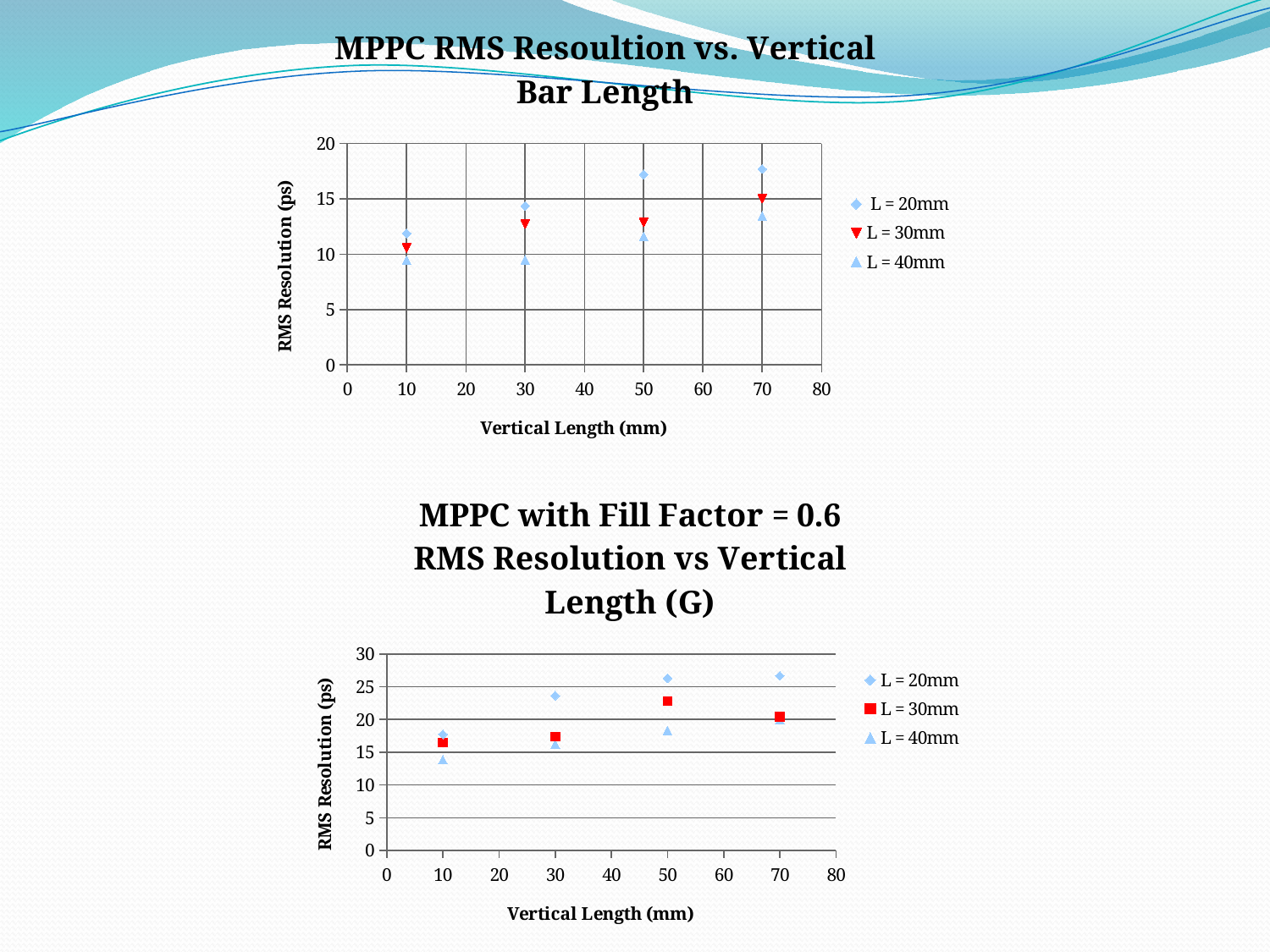
In the top chart, does the RMS resolution for L = 20mm rise or fall as vertical length increases? rise In the top chart, how many series does the legend list? 3 In the bottom chart, 'MPPC with Fill Factor = 0.6', how many series does the legend list? 3 In the bottom chart, is the RMS resolution for L = 20mm at a vertical length of 50 mm greater or less than 25? greater In the top chart, which series has the highest RMS resolution at a vertical length of 70 mm? L = 20mm In the top chart, how many vertical length points are plotted for the L = 20mm series? 4 In the top chart, is the RMS resolution for L = 40mm at a vertical length of 70 mm greater or less than 15? less In the bottom chart, at a vertical length of 50 mm, which series has the larger RMS resolution, L = 30mm or L = 40mm? L = 30mm In the top chart, at a vertical length of 50 mm, which series has the larger RMS resolution, L = 20mm or L = 40mm? L = 20mm What kind of chart is the top chart, 'MPPC RMS Resoultion vs. Vertical Bar Length'? scatter chart In the top chart, is the RMS resolution for L = 20mm at a vertical length of 50 mm greater or less than 15? greater In the bottom chart, which series has the lowest RMS resolution at a vertical length of 10 mm? L = 40mm